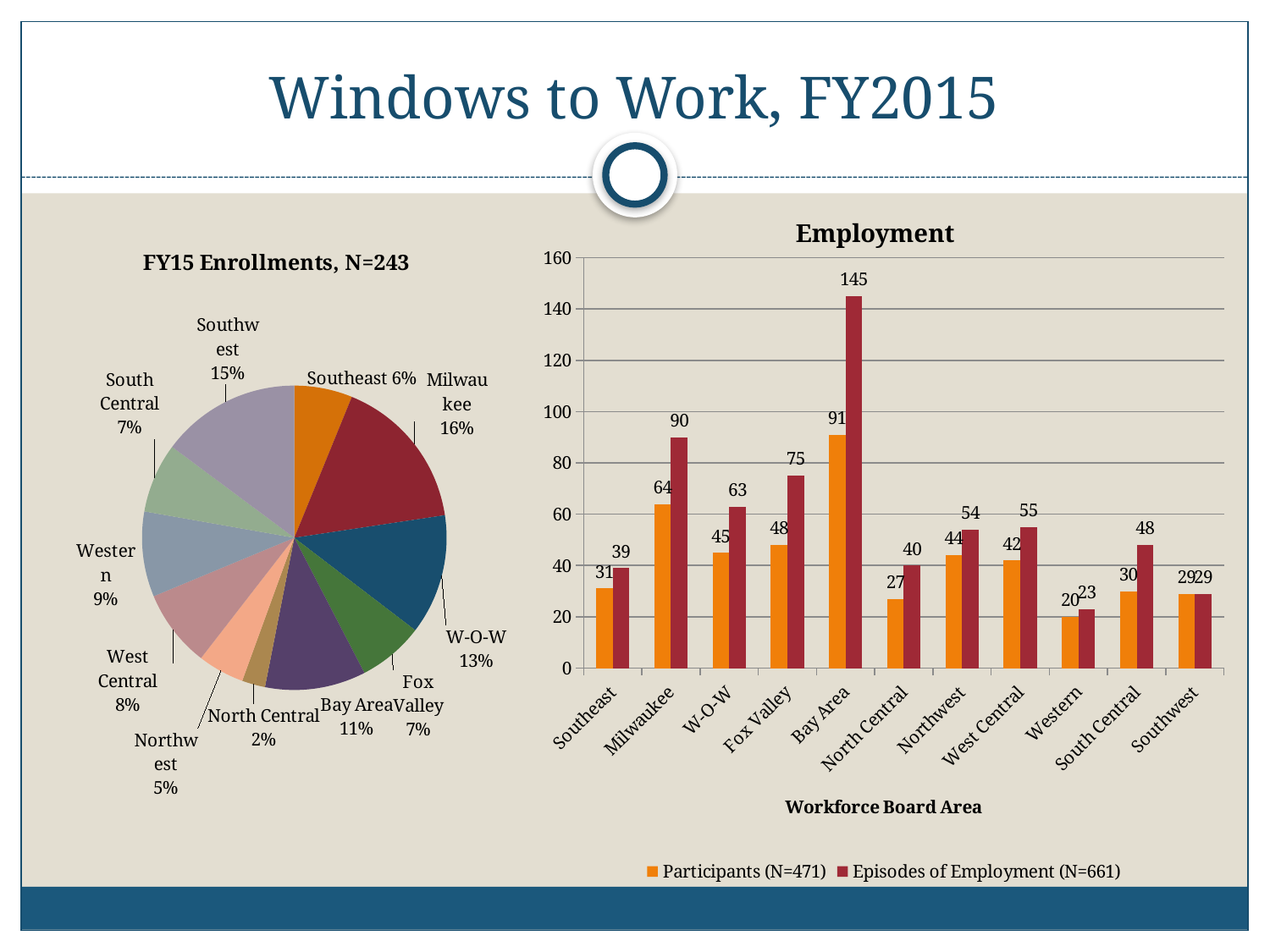
In the FY15 Enrollments pie chart, what share of enrollments is Milwaukee? 16% In the Employment chart, which Workforce Board Area has the highest number of Episodes of Employment? Bay Area How many series does the legend of the Employment chart list? 2 In the Employment chart, what is the number of Episodes of Employment for Bay Area? 145 In the Employment chart, which is larger: Participants for Northwest or Participants for West Central? Northwest In the Employment chart, how many Participants are shown for Milwaukee? 64 What kind of chart is the Employment chart? Bar chart In the Employment chart, which Workforce Board Area has the lowest number of Participants? Western What is the x-axis title of the Employment chart? Workforce Board Area In the FY15 Enrollments pie chart, which area has the smallest share? North Central In the Employment chart, what is the difference between Episodes of Employment and Participants for Fox Valley? 27 How many Workforce Board Areas are shown on the x axis of the Employment chart? 11